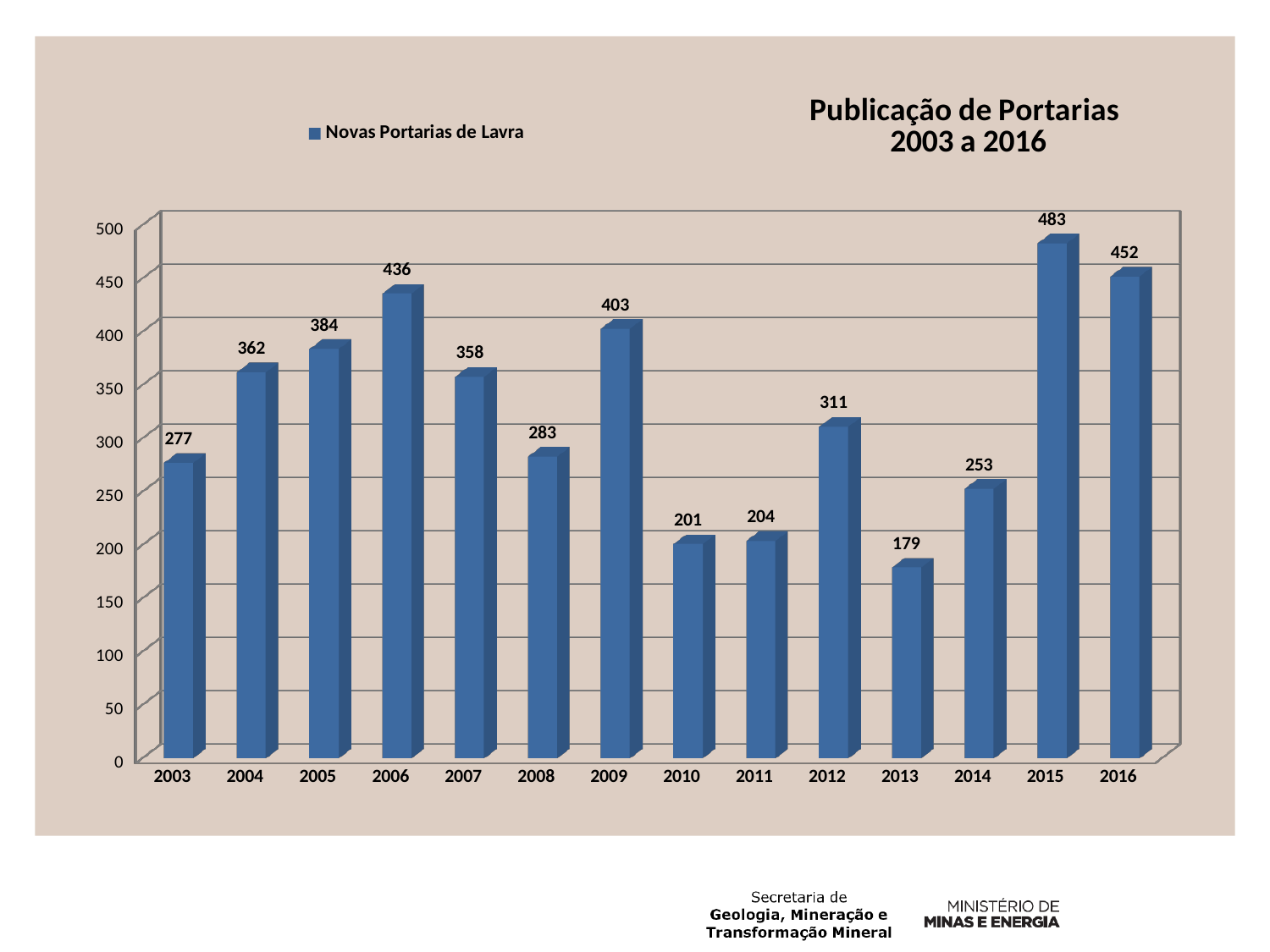
What is the difference between the values for 2015 and 2016? 31 What is the value for 2006? 436 What is the value for 2010? 201 Which year has the lowest value? 2013 Which is larger, the value for 2004 or the value for 2007? 2004 How many years are shown on the x axis? 14 What is the value for 2013? 179 What is the difference between the values for 2009 and 2008? 120 What is the title of the chart? Publicação de Portarias 2003 a 2016 Which year has the highest value? 2015 What kind of chart is this? bar chart Is the value for 2012 greater or less than 300? greater